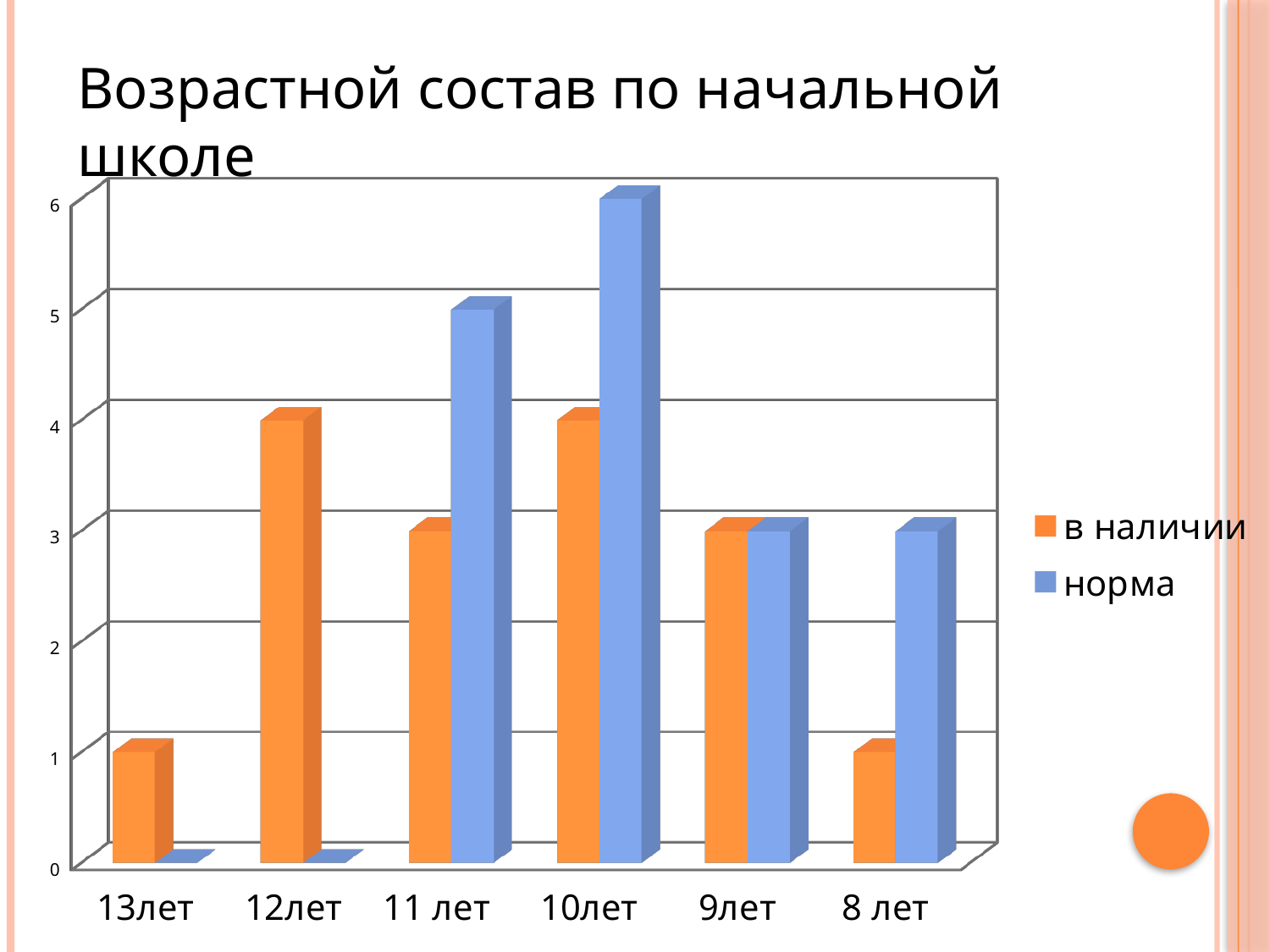
What is the title of the chart? Возрастной состав по начальной школе How many series does the legend list? 2 Which age category has the highest "в наличии" value, 12лет or 10лет, or are they equal? equal Which age category has the highest "норма" value? 10лет What is the difference between "норма" and "в наличии" for 10лет? 2 What is the value of "в наличии" for 12лет? 4 What is the value of "норма" for 10лет? 6 What is the value of "норма" for 11 лет? 5 How many age categories are shown on the x axis? 6 For 8 лет, which is larger: "в наличии" or "норма"? норма What kind of chart is shown on the slide? bar chart What is the value of "в наличии" for 13лет? 1